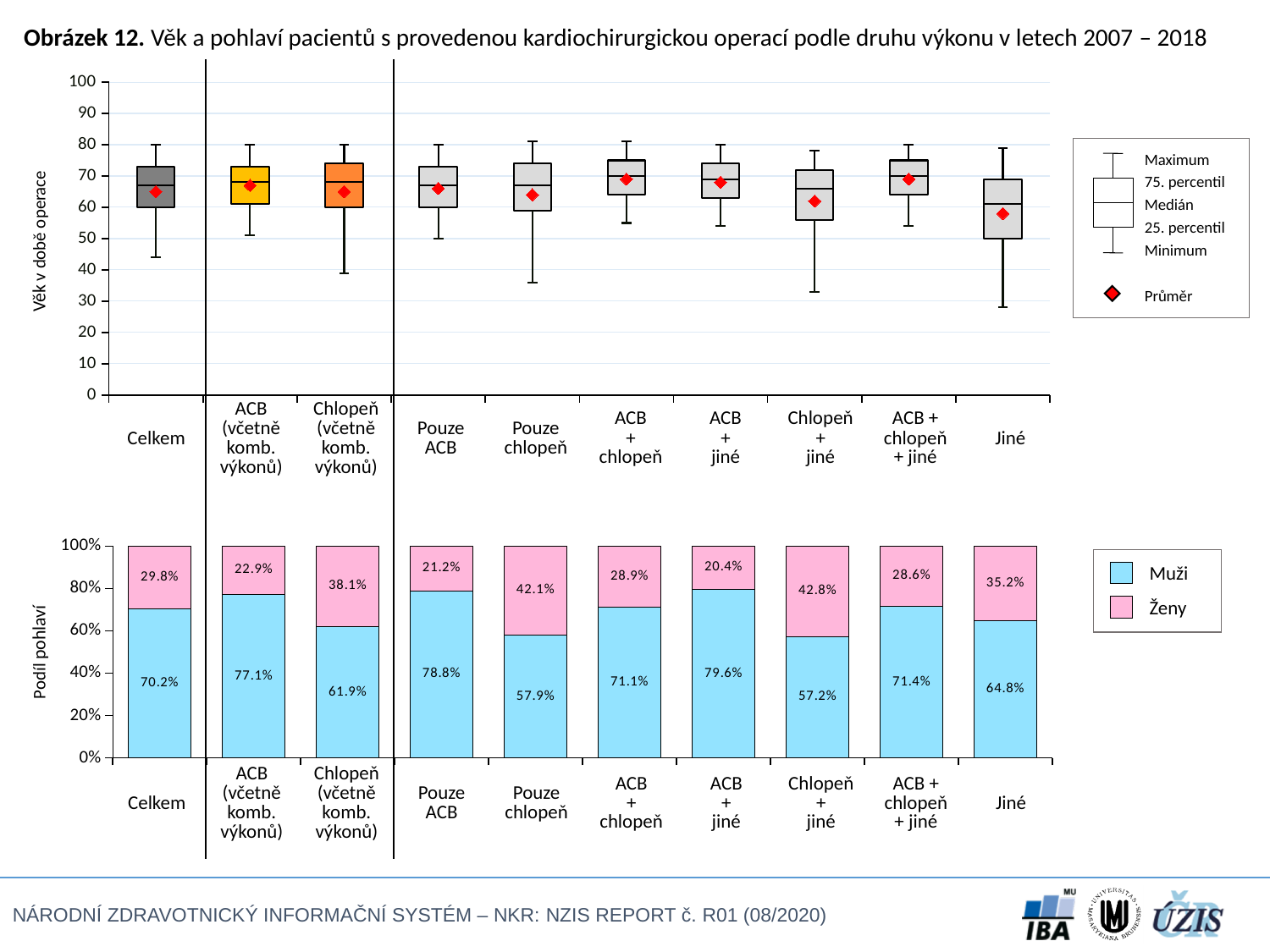
In the top chart (Věk v době operace), is the minimum value for Celkem greater or less than 50? less In the bottom chart (Podíl pohlaví), what is the Ženy share for Pouze chlopeň? 42.1% In the bottom chart (Podíl pohlaví), which category has the lowest Muži share? Chlopeň + jiné In the bottom chart (Podíl pohlaví), what is the Muži share for Celkem? 70.2% How many categories are shown on the x axis of the bottom chart (Podíl pohlaví)? 10 What kind of chart is the bottom chart (Podíl pohlaví)? Stacked bar chart In the bottom chart (Podíl pohlaví), how many series does the legend list? 2 In the bottom chart (Podíl pohlaví), which category has the highest Muži share? ACB + jiné In the top chart (Věk v době operace), what does the red diamond marker represent according to the legend? Průměr In the bottom chart (Podíl pohlaví), what is the Muži share for ACB + chlopeň + jiné? 71.4% In the bottom chart (Podíl pohlaví), which has the larger Muži share: Celkem or Chlopeň (včetně komb. výkonů)? Celkem In the bottom chart (Podíl pohlaví), what is the difference between the Ženy share for Pouze chlopeň and for Pouze ACB? 20.9 percentage points